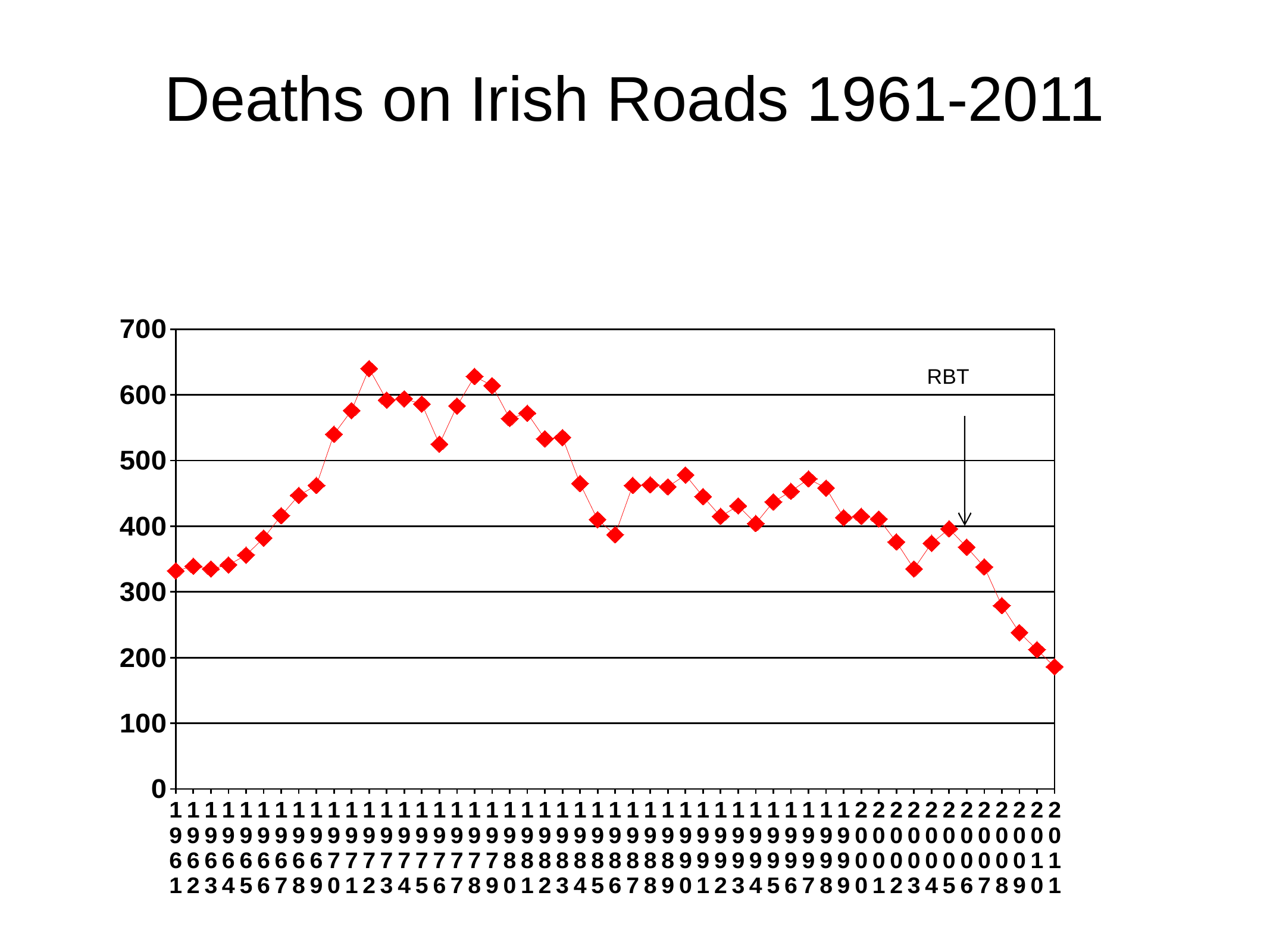
Is the value for 1980 greater or less than 500? greater Do the values rise or fall from 2005 to 2011? Fall Which year has the larger value, 1972 or 1961? 1972 Which year has the lowest number of deaths on the chart? 2011 Is the value for 2008 greater or less than 300? less What text label is attached to the arrow annotation on the chart? RBT Is the value for 1972 greater or less than 600? greater How many yearly data points are plotted on the chart? 51 What is the title of the chart? Deaths on Irish Roads 1961-2011 What kind of chart is shown on the slide? Line chart